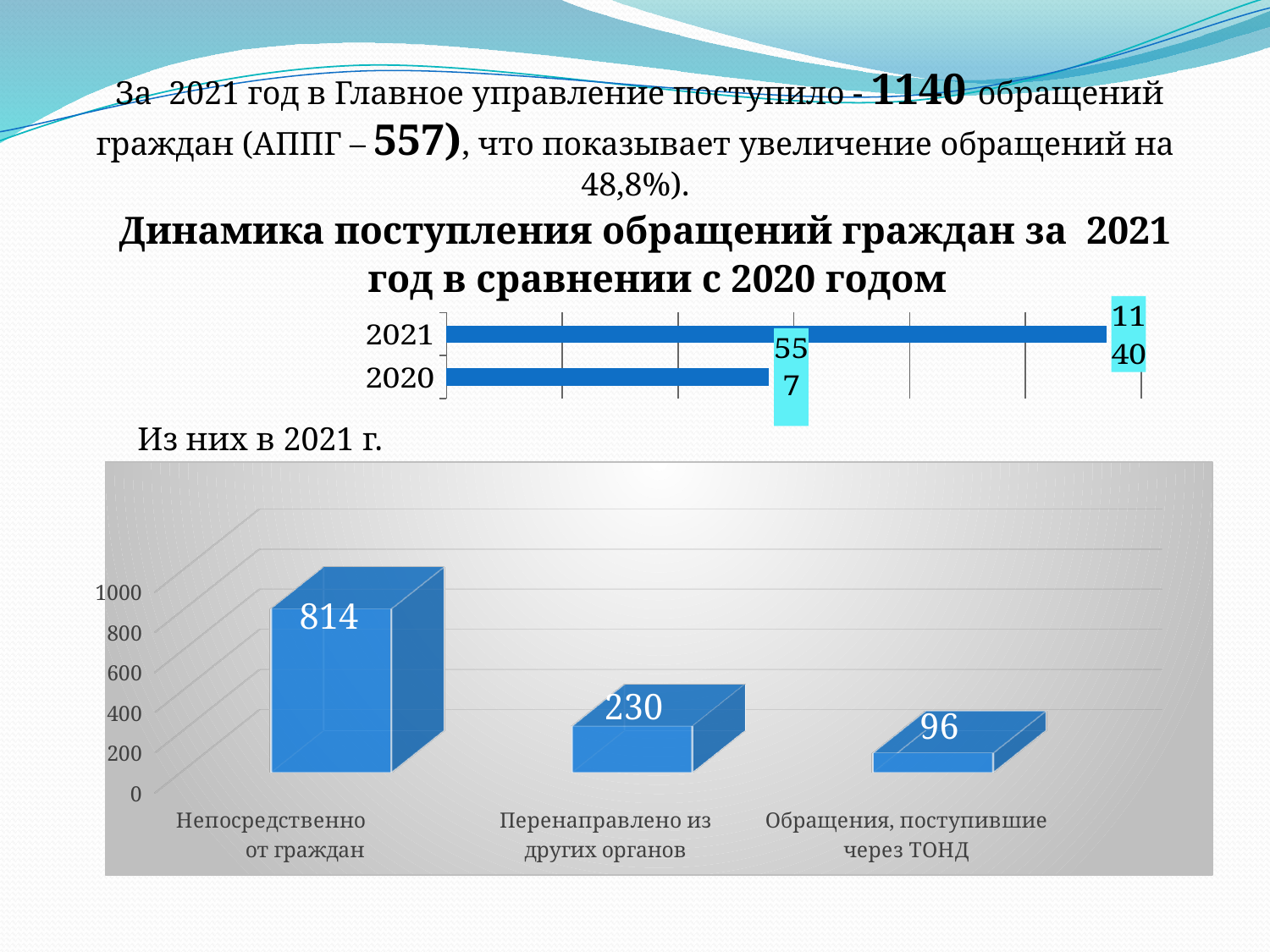
In the top chart (Динамика поступления обращений граждан), what is the value for 2020? 557 In the top chart (Динамика поступления обращений граждан), which year has the larger value, 2021 or 2020? 2021 In the top chart (Динамика поступления обращений граждан), what is the difference between the 2021 and 2020 values? 583 In the bottom chart (Из них в 2021 г.), what is the value for 'Перенаправлено из других органов'? 230 In the top chart (Динамика поступления обращений граждан), what is the value for 2021? 1140 In the top chart (Динамика поступления обращений граждан), how many bars are plotted? 2 In the bottom chart (Из них в 2021 г.), what is the difference between 'Непосредственно от граждан' and 'Перенаправлено из других органов'? 584 In the bottom chart (Из них в 2021 г.), how many categories are shown? 3 What kind of chart is the top chart (Динамика поступления обращений граждан)? Bar chart In the bottom chart (Из них в 2021 г.), which category has the lowest value? Обращения, поступившие через ТОНД In the bottom chart (Из них в 2021 г.), what is the value for 'Непосредственно от граждан'? 814 In the bottom chart (Из них в 2021 г.), what is the value for 'Обращения, поступившие через ТОНД'? 96